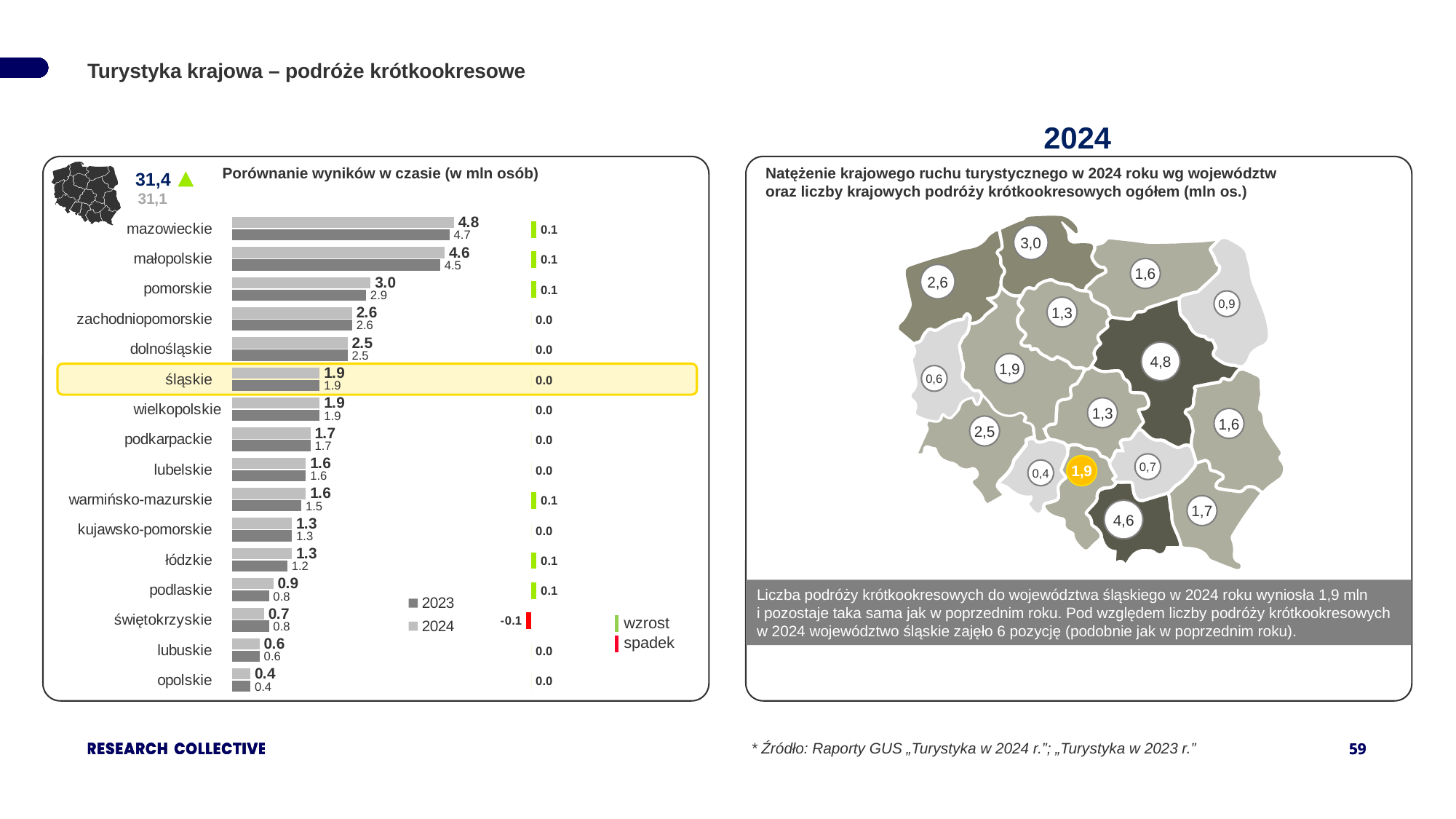
In the bar chart 'Porównanie wyników w czasie (w mln osób)', what change value is shown for świętokrzyskie? -0.1 In the bar chart 'Porównanie wyników w czasie (w mln osób)', what is the 2023 value for mazowieckie? 4.7 How many series does the legend of the bar chart 'Porównanie wyników w czasie (w mln osób)' list? 2 What kind of chart is 'Porównanie wyników w czasie (w mln osób)'? bar chart In the bar chart 'Porównanie wyników w czasie (w mln osób)', which voivodeship has the lowest 2024 value? opolskie In the bar chart 'Porównanie wyników w czasie (w mln osób)', what is the 2023 value for podlaskie? 0.8 How many voivodeships are listed in the bar chart 'Porównanie wyników w czasie (w mln osób)'? 16 In the bar chart 'Porównanie wyników w czasie (w mln osób)', what is the 2024 value for mazowieckie? 4.8 In the bar chart 'Porównanie wyników w czasie (w mln osób)', what is the difference between the 2024 values for mazowieckie and małopolskie? 0.2 On the map chart on the right, what value is shown for the highlighted (yellow) śląskie voivodeship? 1,9 In the bar chart 'Porównanie wyników w czasie (w mln osób)', which voivodeship has the highest 2024 value? mazowieckie In the bar chart 'Porównanie wyników w czasie (w mln osób)', which has the larger 2024 value, pomorskie or zachodniopomorskie? pomorskie